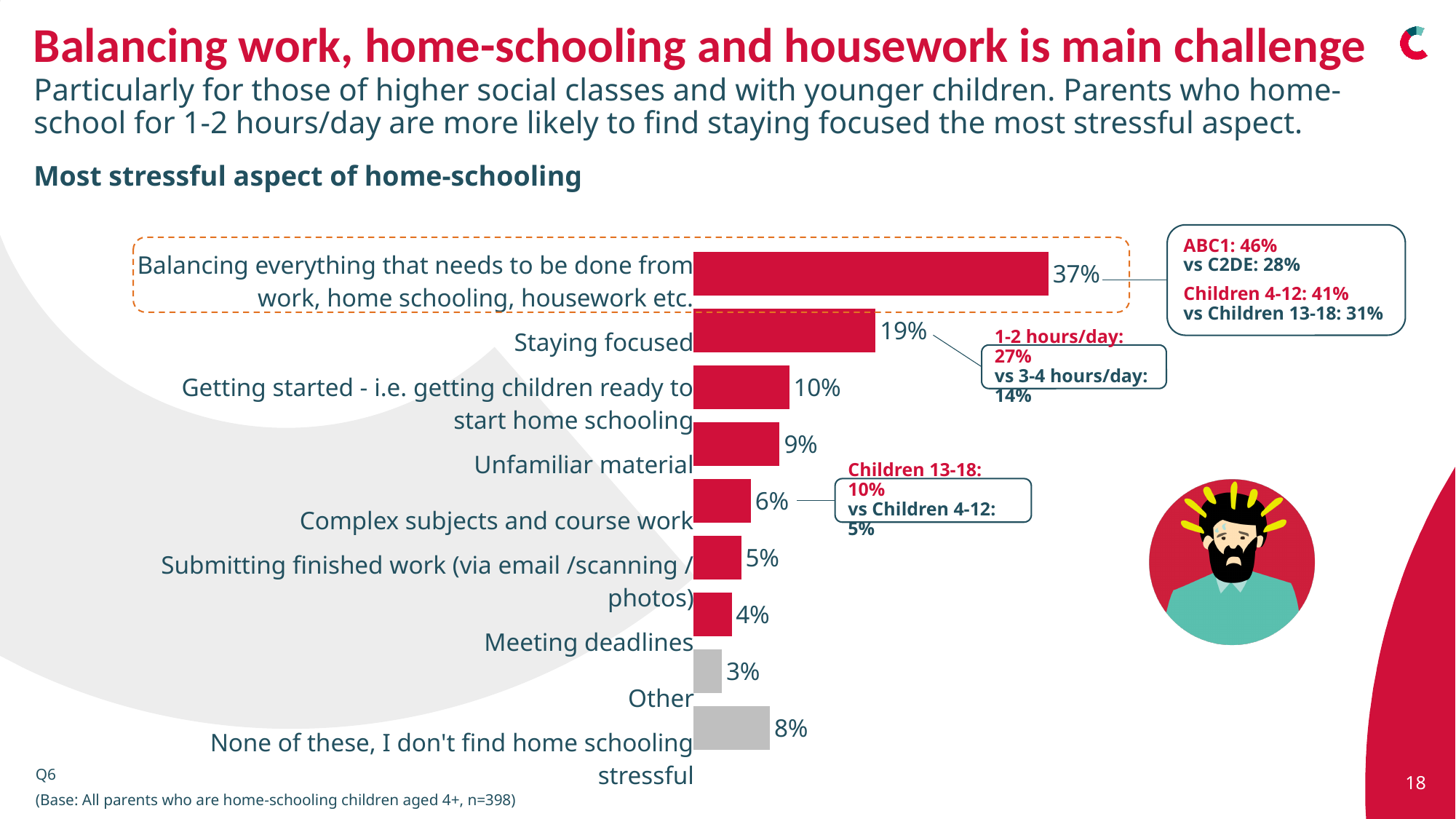
What is the title of the chart on the slide? Most stressful aspect of home-schooling Which category has the lowest percentage in the chart? Other What is the difference in percentage points between 'Balancing everything that needs to be done from work, home schooling, housework etc.' and 'Staying focused'? 18 Which aspect of home-schooling has the highest percentage in the chart? Balancing everything that needs to be done from work, home schooling, housework etc. How many categories are shown in the chart? 9 What is the value shown for 'Meeting deadlines'? 4% What type of chart is used to show the most stressful aspect of home-schooling? Bar chart What is the difference in percentage points between 'Getting started - i.e. getting children ready to start home schooling' and 'Submitting finished work (via email /scanning / photos)'? 5 What percentage of parents say balancing everything that needs to be done from work, home schooling, housework etc. is the most stressful aspect of home-schooling? 37% What percentage of parents chose 'None of these, I don't find home schooling stressful'? 8% Which has a higher value: 'Unfamiliar material' or 'Complex subjects and course work'? Unfamiliar material What is the value for 'Staying focused' in the chart? 19%